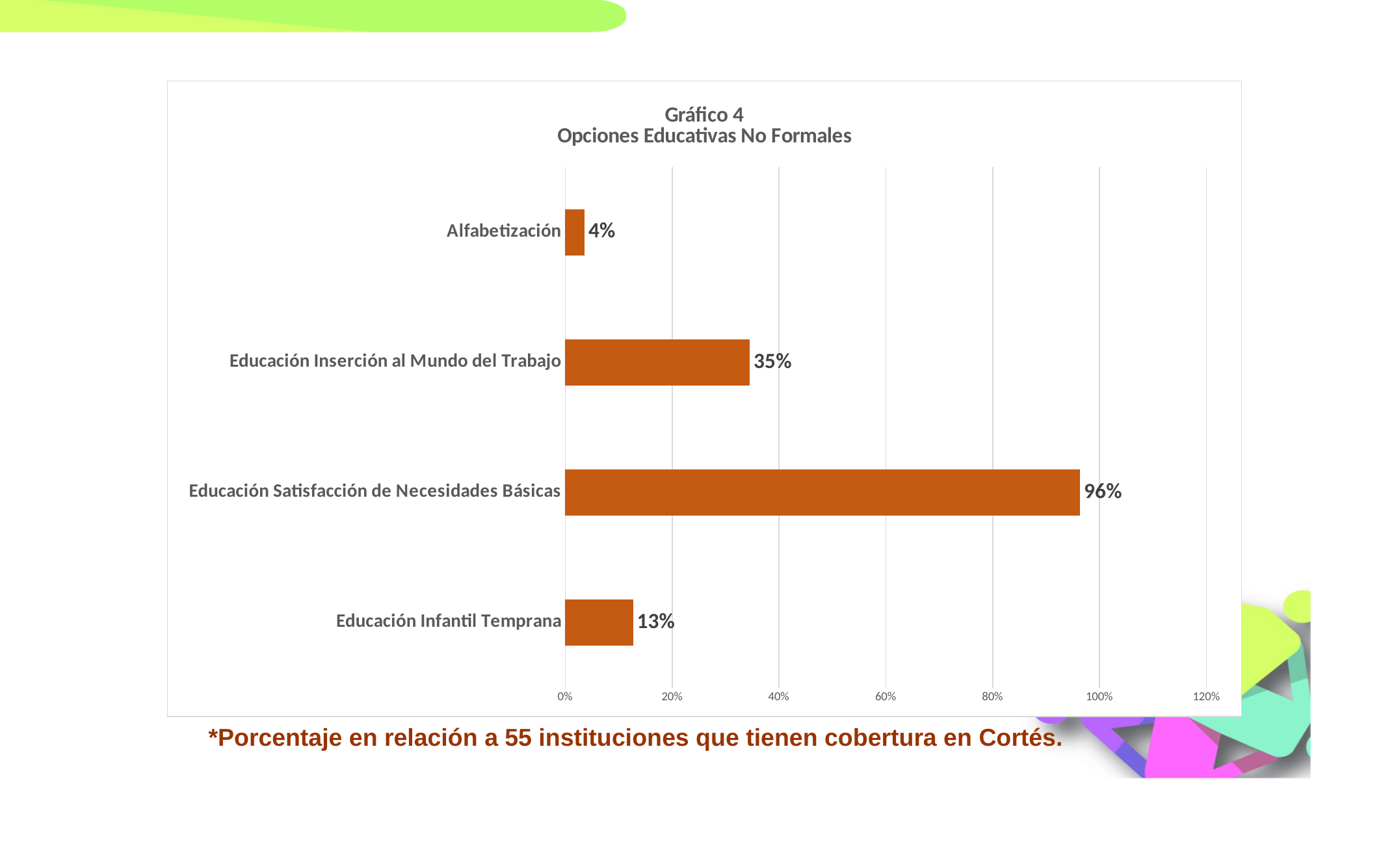
Which category has the highest value? Educación Satisfacción de Necesidades Básicas How many categories are shown in the chart? 4 What kind of chart is shown on the slide? bar chart What is the value for Educación Infantil Temprana? 13% What is the title of the chart? Gráfico 4 Opciones Educativas No Formales Which is larger, the value for Educación Infantil Temprana or the value for Alfabetización? Educación Infantil Temprana Which category has the lowest value? Alfabetización What is the value for Alfabetización? 4% What is the value for Educación Satisfacción de Necesidades Básicas? 96% What is the value for Educación Inserción al Mundo del Trabajo? 35% What is the difference between the values for Educación Satisfacción de Necesidades Básicas and Educación Inserción al Mundo del Trabajo? 61% Is the value for Educación Inserción al Mundo del Trabajo greater or less than 40%? less